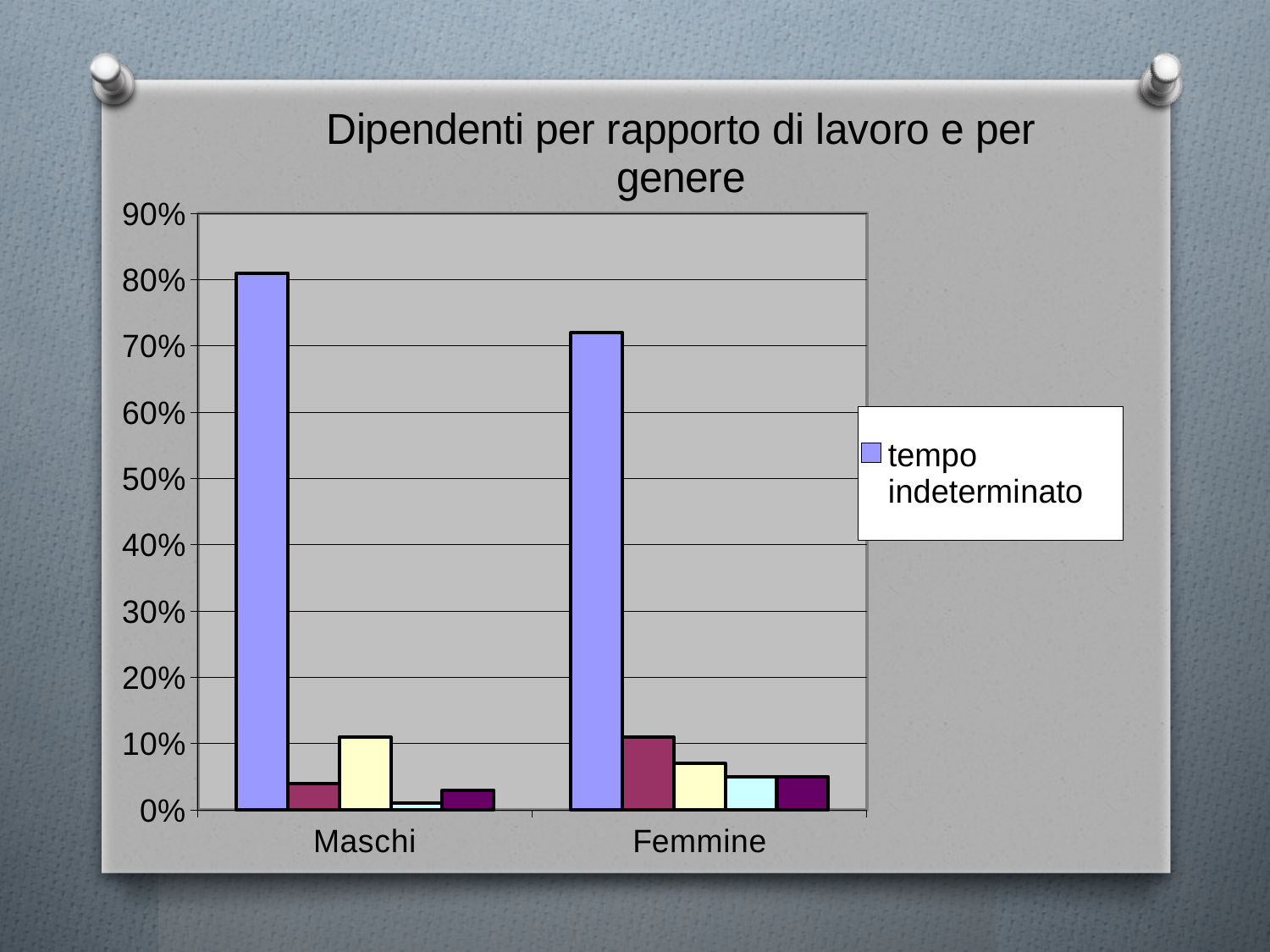
Which category has the lowest value for tempo indeterminato? Femmine Is the value for tempo indeterminato for Femmine greater or less than 80%? less How many categories are shown on the x axis of the chart? 2 What kind of chart is shown on the slide? bar chart Which series is named in the legend? tempo indeterminato How many series does the legend list? 1 Is the value for tempo indeterminato for Femmine greater or less than 60%? greater Which category has the higher value for tempo indeterminato, Maschi or Femmine? Maschi Is the value for tempo indeterminato for Maschi greater or less than 70%? greater Which category has the highest value for tempo indeterminato? Maschi Does the value for tempo indeterminato rise or fall from Maschi to Femmine? fall What is the title of the chart? Dipendenti per rapporto di lavoro e per genere